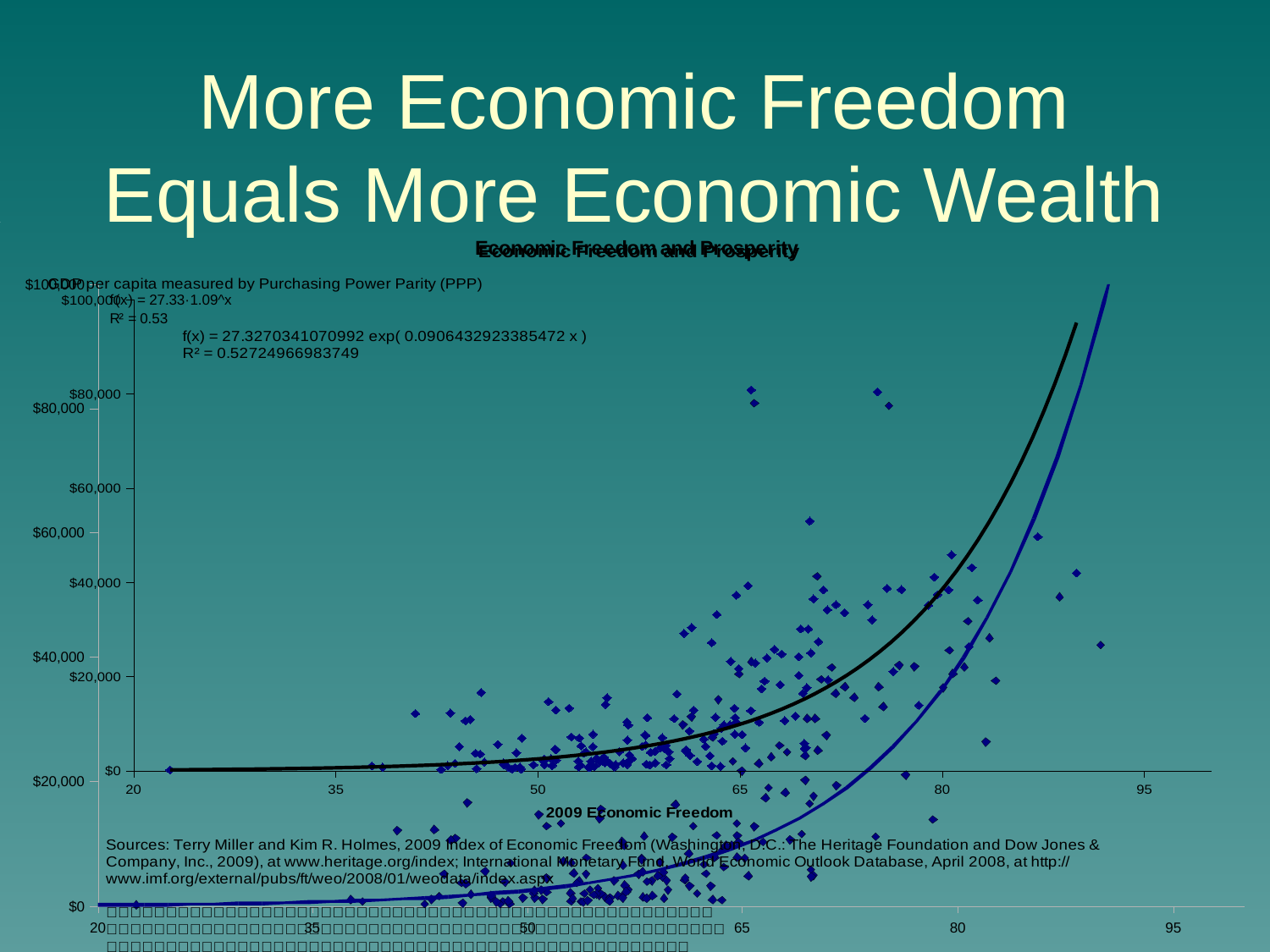
What is the highest value labelled on the y axis? $100,000 What is the rounded trendline equation printed on the chart? f(x) = 27.33·1.09^x What R² value, rounded to two decimal places, is shown for the trendline? 0.53 What is the label on the x axis of the chart? 2009 Economic Freedom What is the lowest value labelled on the x axis? 20 What kind of chart is shown on the slide? Scatter chart As the 2009 Economic Freedom score increases along the x axis, does the fitted trendline rise or fall? Rise What is the full (unrounded) R² value printed on the chart? 0.52724966983749 What is the interval between consecutive y-axis tick labels? $20,000 How many tick labels are shown on the x axis? 6 What is the highest value labelled on the x axis? 95 What is the title of the chart? Economic Freedom and Prosperity